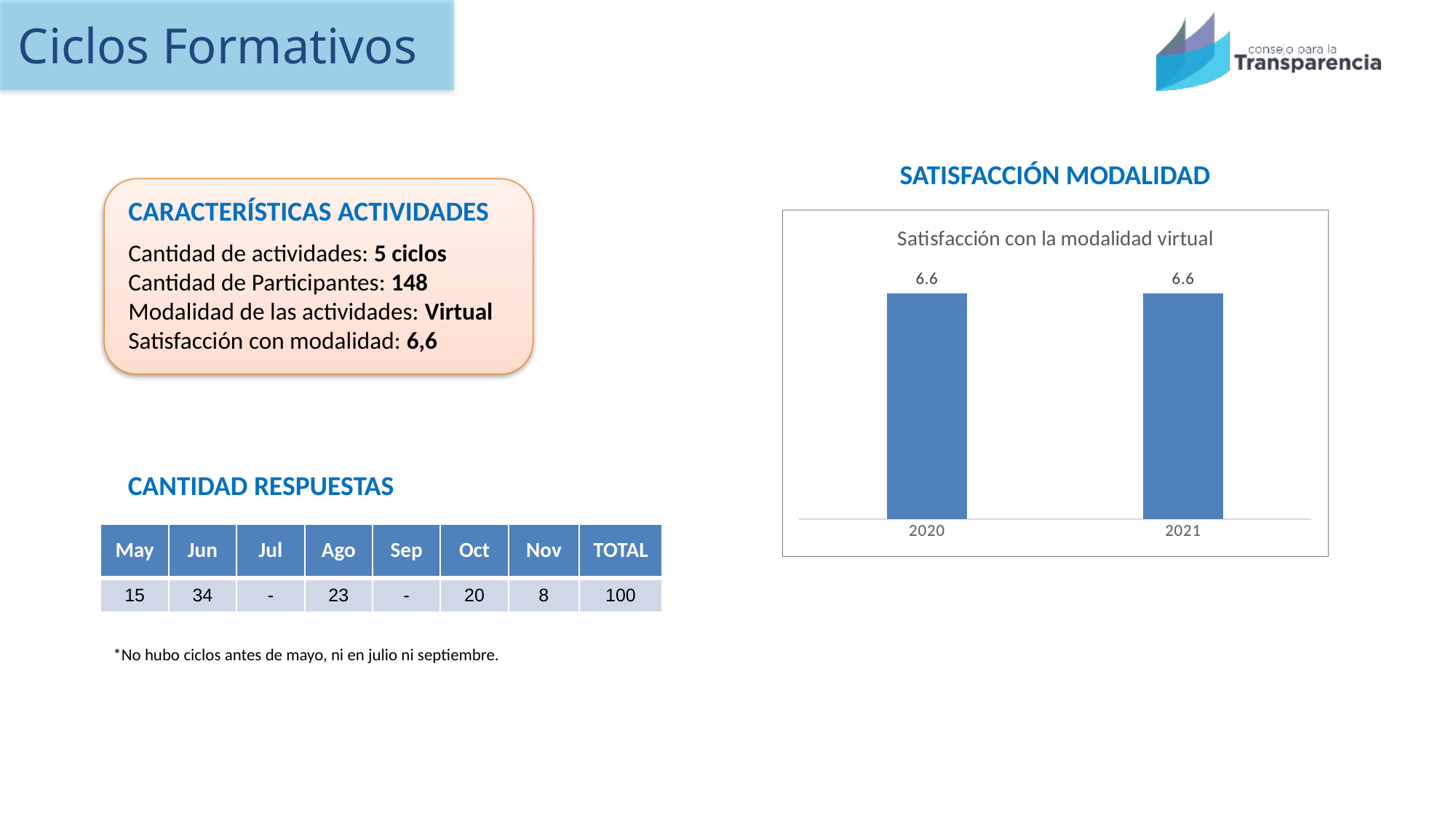
What is the value for 2021 in the chart titled "Satisfacción con la modalidad virtual"? 6.6 What colour are the bars in the chart "Satisfacción con la modalidad virtual"? Blue What kind of chart is "Satisfacción con la modalidad virtual"? Bar chart What is the title of the chart on the right side of the slide? Satisfacción con la modalidad virtual Which years are shown on the x axis of the chart "Satisfacción con la modalidad virtual"? 2020 and 2021 Do the values in the chart "Satisfacción con la modalidad virtual" rise, fall, or stay the same from 2020 to 2021? Stay the same How many categories are plotted in the chart "Satisfacción con la modalidad virtual"? 2 What is the difference between the 2021 and 2020 values in the chart "Satisfacción con la modalidad virtual"? 0 What is the value for 2020 in the chart titled "Satisfacción con la modalidad virtual"? 6.6